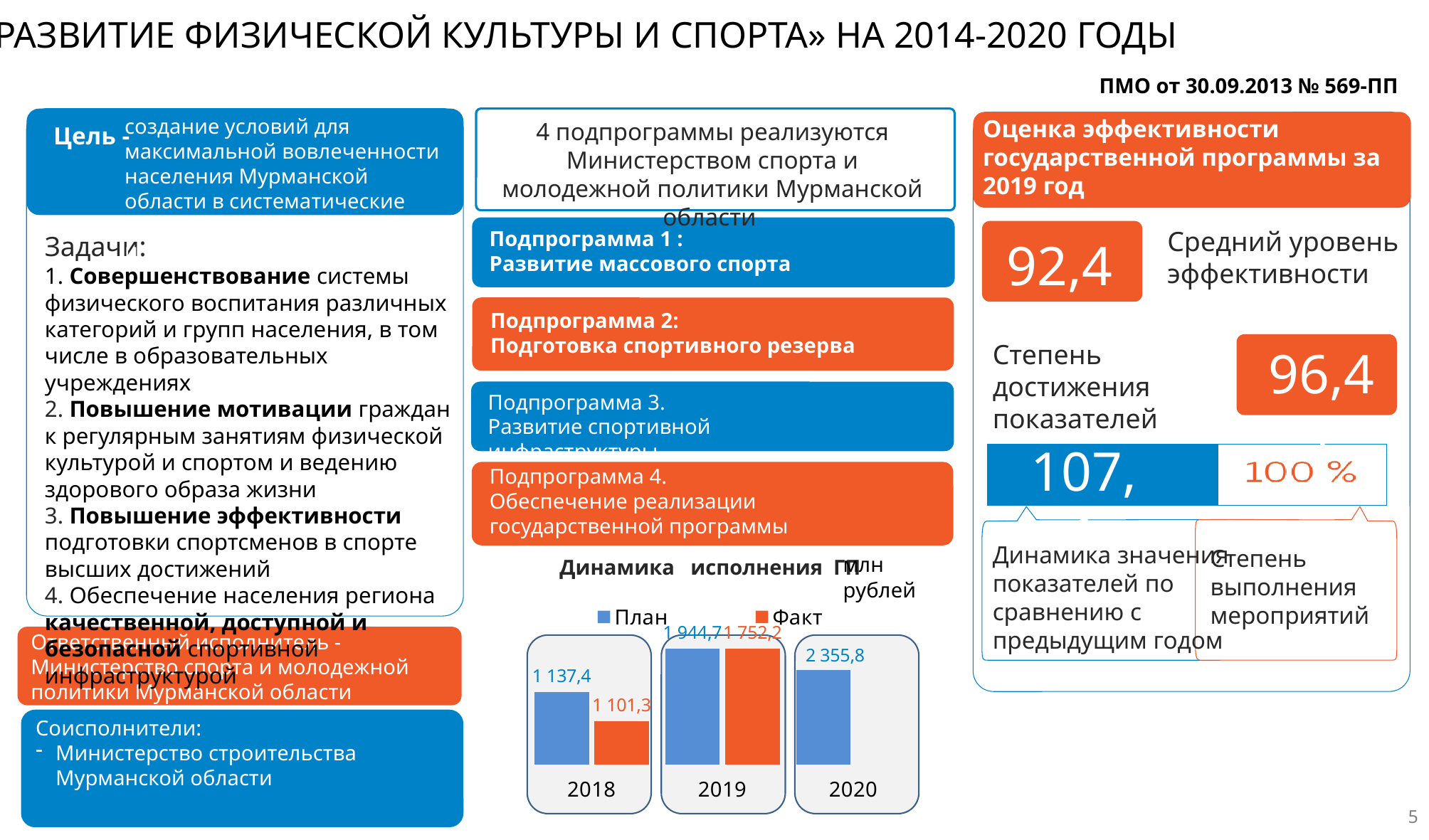
In the chart 'Динамика исполнения ГП', which is larger for 2018: План or Факт? План In the chart 'Динамика исполнения ГП', which year has the lowest План value? 2018 What type of chart is 'Динамика исполнения ГП'? Bar chart What is the План value for 2020 in the chart 'Динамика исполнения ГП'? 2 355,8 How many series does the legend of the chart 'Динамика исполнения ГП' list? 2 What is the План value for 2018 in the chart 'Динамика исполнения ГП'? 1 137,4 What is the Факт value for 2019 in the chart 'Динамика исполнения ГП'? 1 752,2 What is the Факт value for 2018 in the chart 'Динамика исполнения ГП'? 1 101,3 What is the План value for 2019 in the chart 'Динамика исполнения ГП'? 1 944,7 In the chart 'Динамика исполнения ГП', does the План value rise or fall from 2018 to 2020? Rise In the chart 'Динамика исполнения ГП', what is the difference between План and Факт for 2019? 192,5